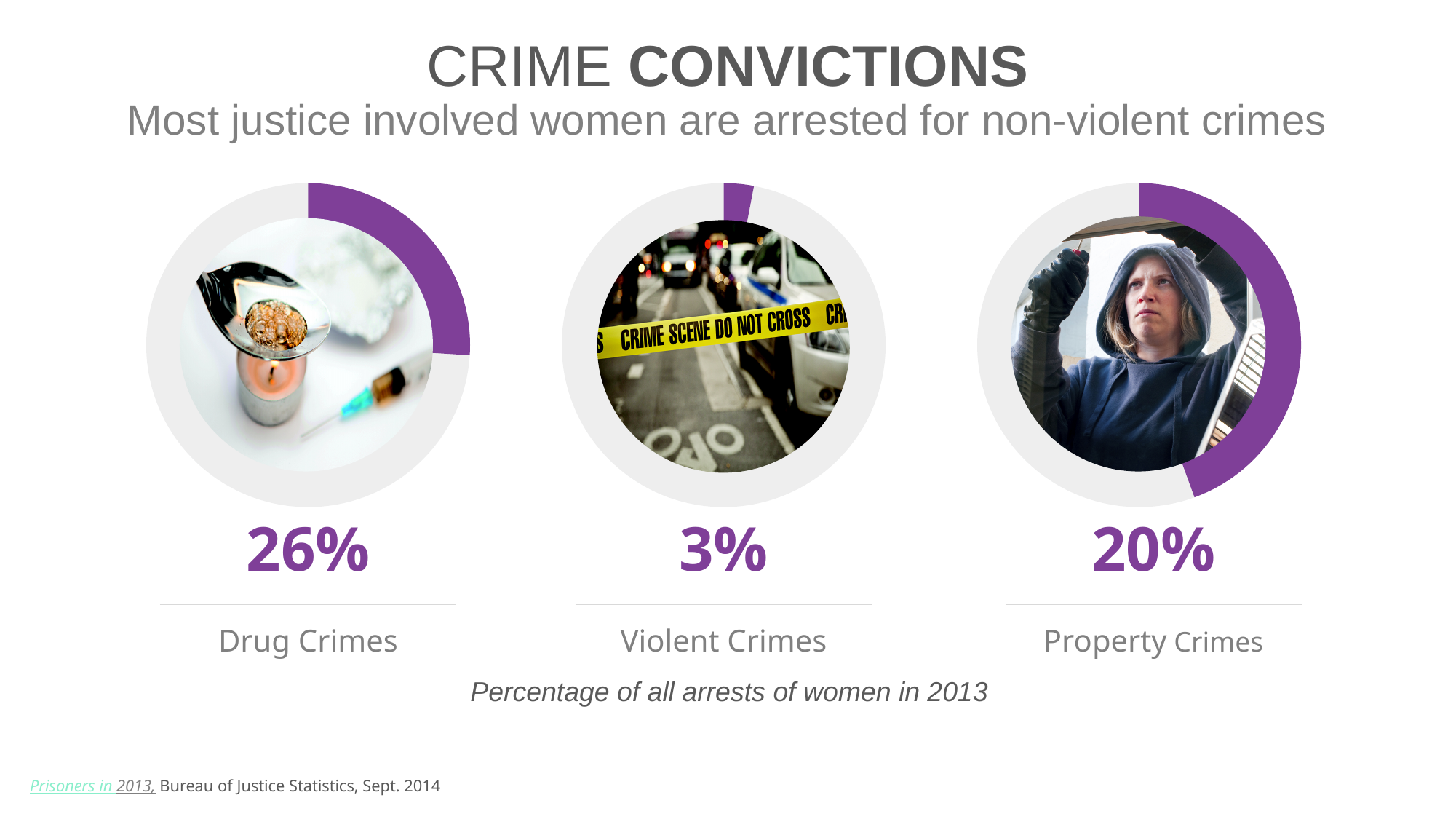
How many crime categories are shown on the slide? 3 Which is larger, the percentage for Violent Crimes or for Property Crimes? Property Crimes Which is larger, the percentage for Drug Crimes or for Property Crimes? Drug Crimes Which crime category has the lowest percentage of arrests of women in 2013? Violent Crimes What colour is used for the filled portion of each donut chart? Purple What percentage of all arrests of women in 2013 were for Drug Crimes? 26% What percentage of all arrests of women in 2013 were for Violent Crimes? 3% What is the difference in percentage points between Property Crimes and Violent Crimes? 17 Which crime category has the highest percentage of arrests of women in 2013? Drug Crimes What kind of chart is used to show each crime category's percentage? Donut chart What percentage of all arrests of women in 2013 were for Property Crimes? 20% What is the difference in percentage points between Drug Crimes and Property Crimes? 6